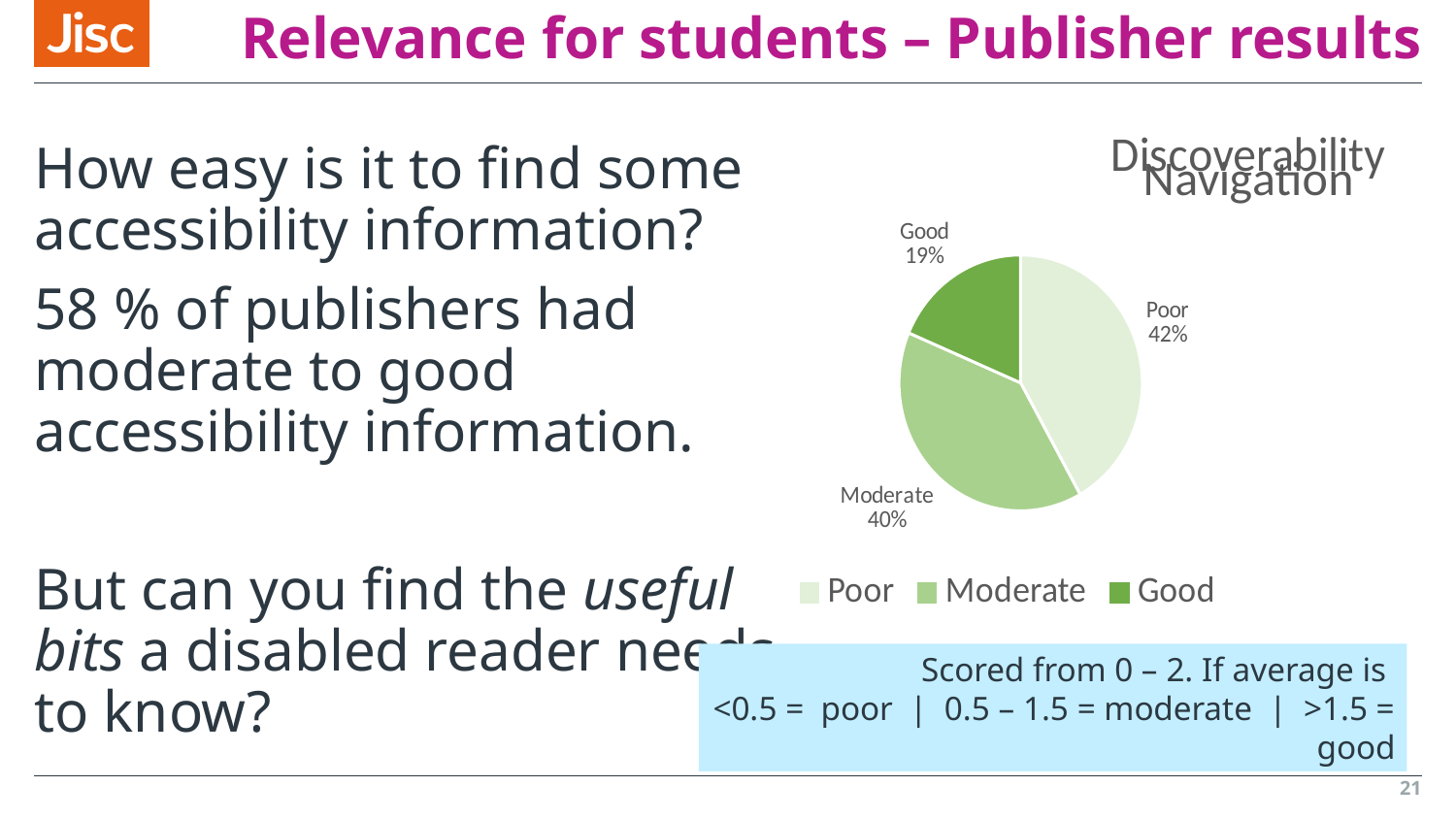
Which category has the largest share of the pie chart? Poor What is the difference in percentage points between the Moderate and Good slices? 21 What are the three entries listed in the chart legend? Poor, Moderate, Good Which category has the smallest share of the pie chart? Good What percentage of the pie chart is labelled Good? 19% What is the difference in percentage points between the Poor and Good slices? 23 What type of chart is shown on the slide? Pie chart What percentage of the pie chart is labelled Moderate? 40% How many slices does the pie chart have? 3 What is the combined share of the Moderate and Good slices? 59% Which slice is larger, Moderate or Good? Moderate What percentage of the pie chart is labelled Poor? 42%